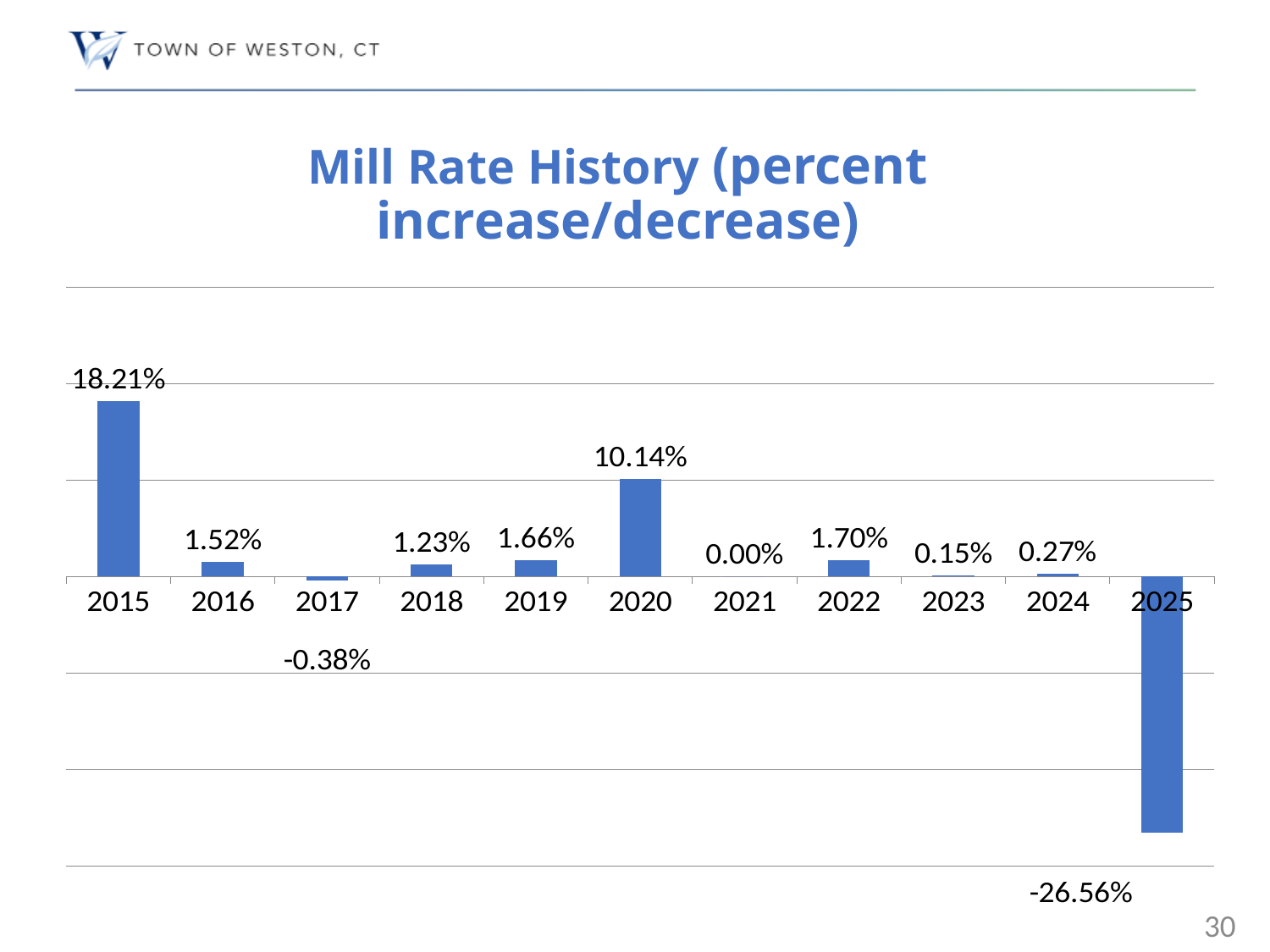
What is the mill rate percent change shown for 2020? 10.14% What is the mill rate percent change shown for 2025? -26.56% What is the mill rate percent change shown for 2017? -0.38% Which year has the lowest mill rate percent change? 2025 What is the difference between the 2015 and 2020 values? 8.07% Which year has the highest mill rate percent change? 2015 How many years are shown on the x axis? 11 Which is larger, the value for 2022 or the value for 2019? 2022 What kind of chart is shown on the slide? Bar chart What is the mill rate percent change shown for 2021? 0.00% What is the mill rate percent change shown for 2015? 18.21% What is the title of the chart? Mill Rate History (percent increase/decrease)